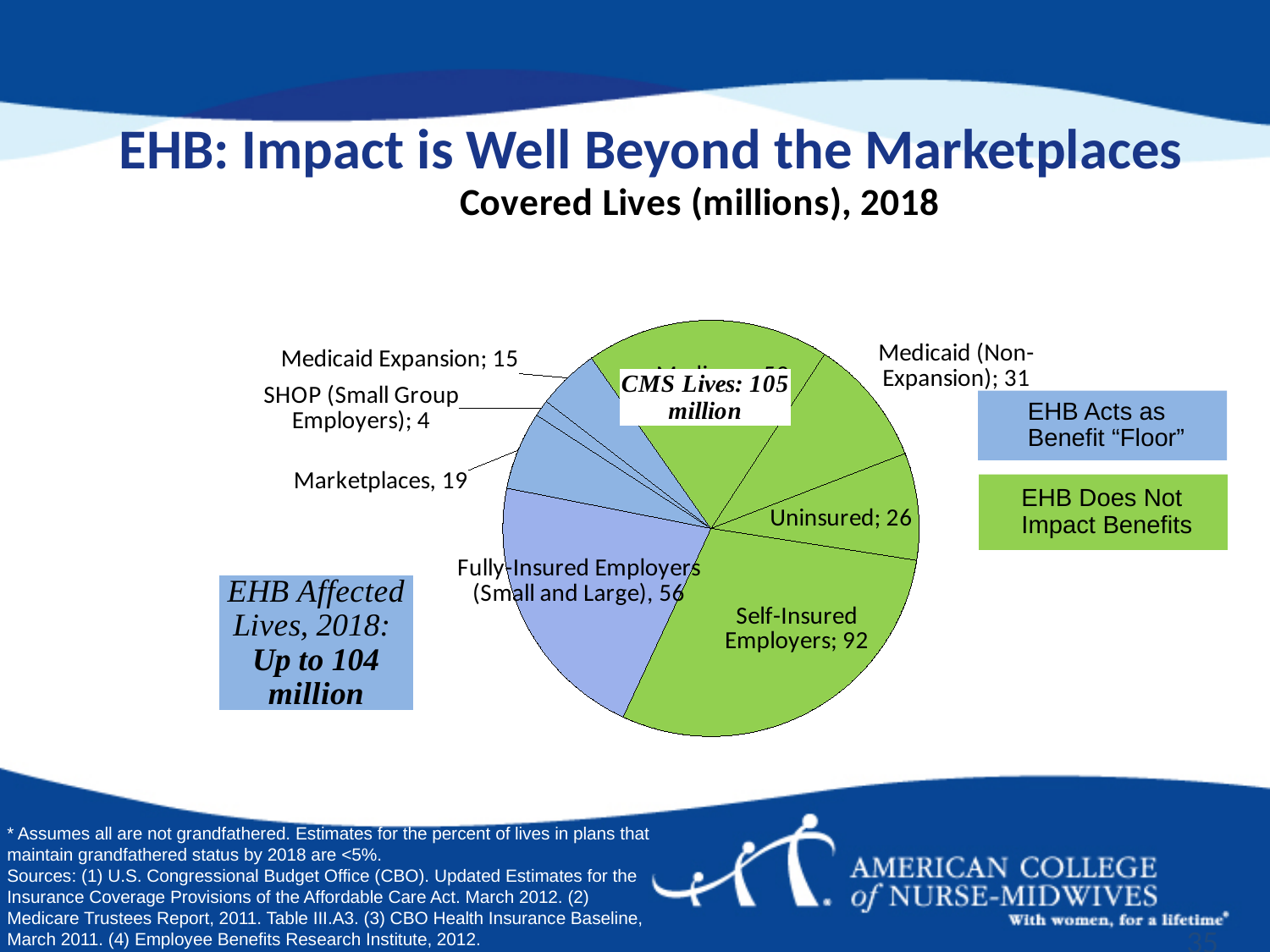
Which labeled category has the smallest value in the pie chart? SHOP (Small Group Employers) What is the title of the chart on the slide? Covered Lives (millions), 2018 What is the value for Fully-Insured Employers (Small and Large) in the pie chart? 56 Which is larger: the value for Uninsured or the value for Medicaid (Non-Expansion)? Medicaid (Non-Expansion) What is the value for Uninsured in the pie chart? 26 What is the value for Marketplaces in the pie chart? 19 What is the value for Self-Insured Employers in the pie chart? 92 What is the value for Medicaid (Non-Expansion) in the pie chart? 31 What is the value for SHOP (Small Group Employers) in the pie chart? 4 What is the difference between the values for Self-Insured Employers and Fully-Insured Employers (Small and Large)? 36 What kind of chart is shown on the slide? Pie chart Which labeled category has the largest value in the pie chart? Self-Insured Employers